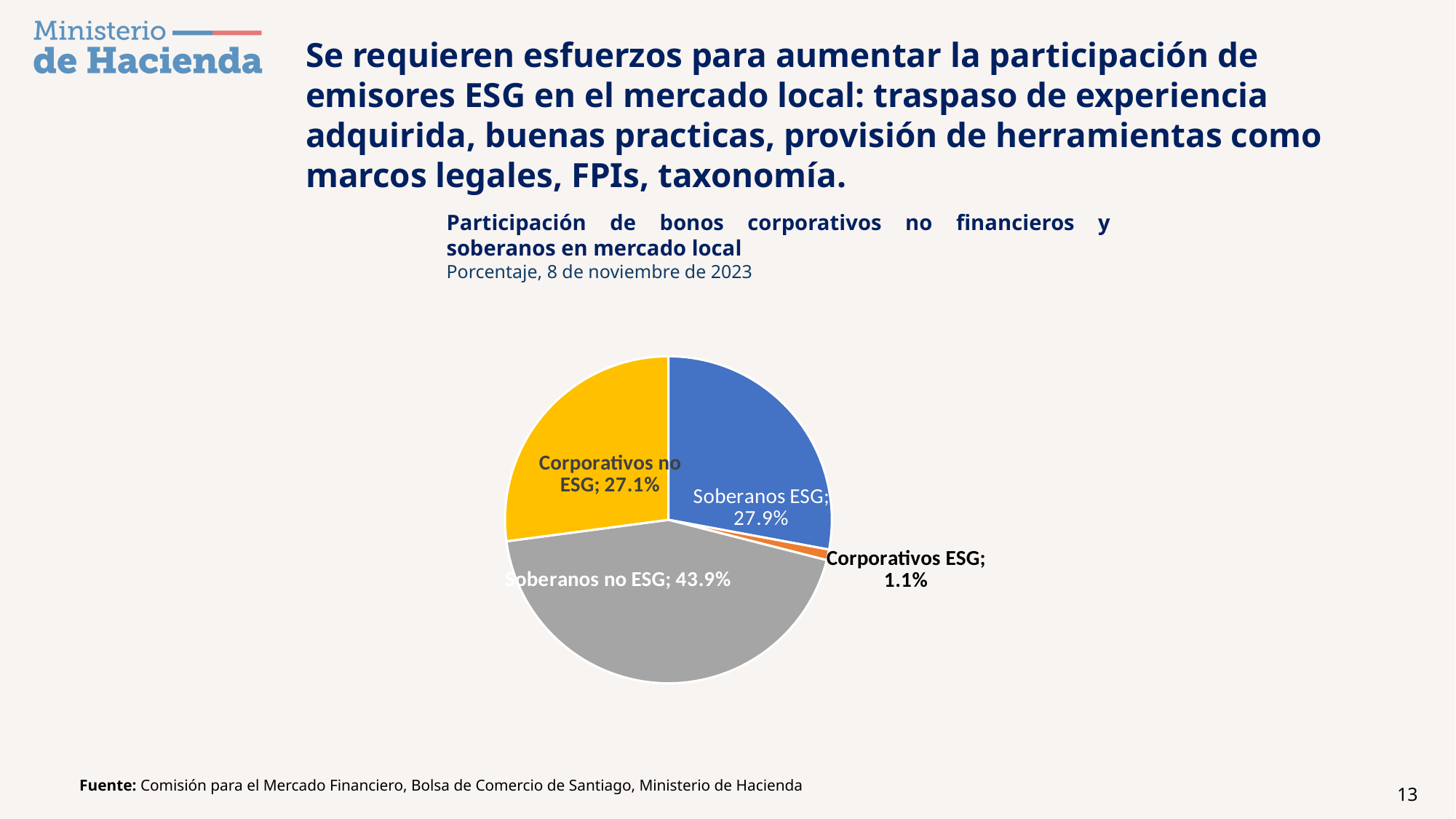
Which category has the smallest share of the pie? Corporativos ESG What is the share for Soberanos ESG? 27.9% What is the difference in percentage points between Soberanos no ESG and Soberanos ESG? 16.0 percentage points What kind of chart is shown on the slide? pie chart How many slices does the pie chart have? 4 What is the share for Corporativos no ESG? 27.1% What is the combined share of Soberanos ESG and Corporativos ESG? 29.0% Which is larger, the share for Soberanos no ESG or the share for Corporativos no ESG? Soberanos no ESG What is the share for Soberanos no ESG? 43.9% What colour is the Soberanos ESG slice? blue What is the share for Corporativos ESG? 1.1% Which category has the largest share of the pie? Soberanos no ESG